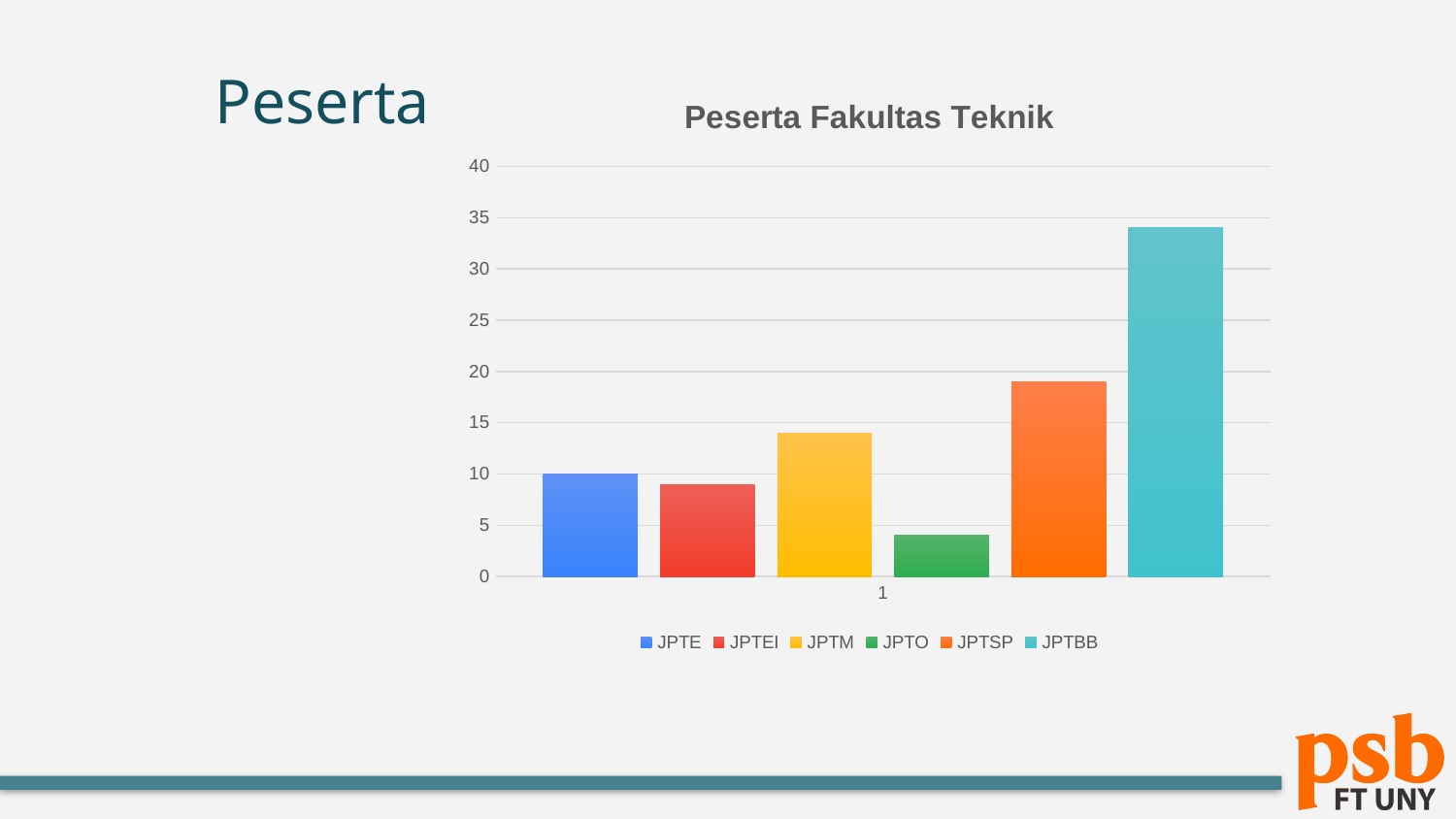
Which is larger, the value for JPTSP or the value for JPTM? JPTSP Is the value for JPTBB greater or less than 30? greater Which series has the lowest value? JPTO Is the value for JPTM greater or less than 15? less What is the title of the chart? Peserta Fakultas Teknik Is the value for JPTSP greater or less than 15? greater Which series has the highest value? JPTBB Which legend entry is shown in green? JPTO What kind of chart is shown on the slide? bar chart How many series does the legend list? 6 How many bars are plotted in the chart? 6